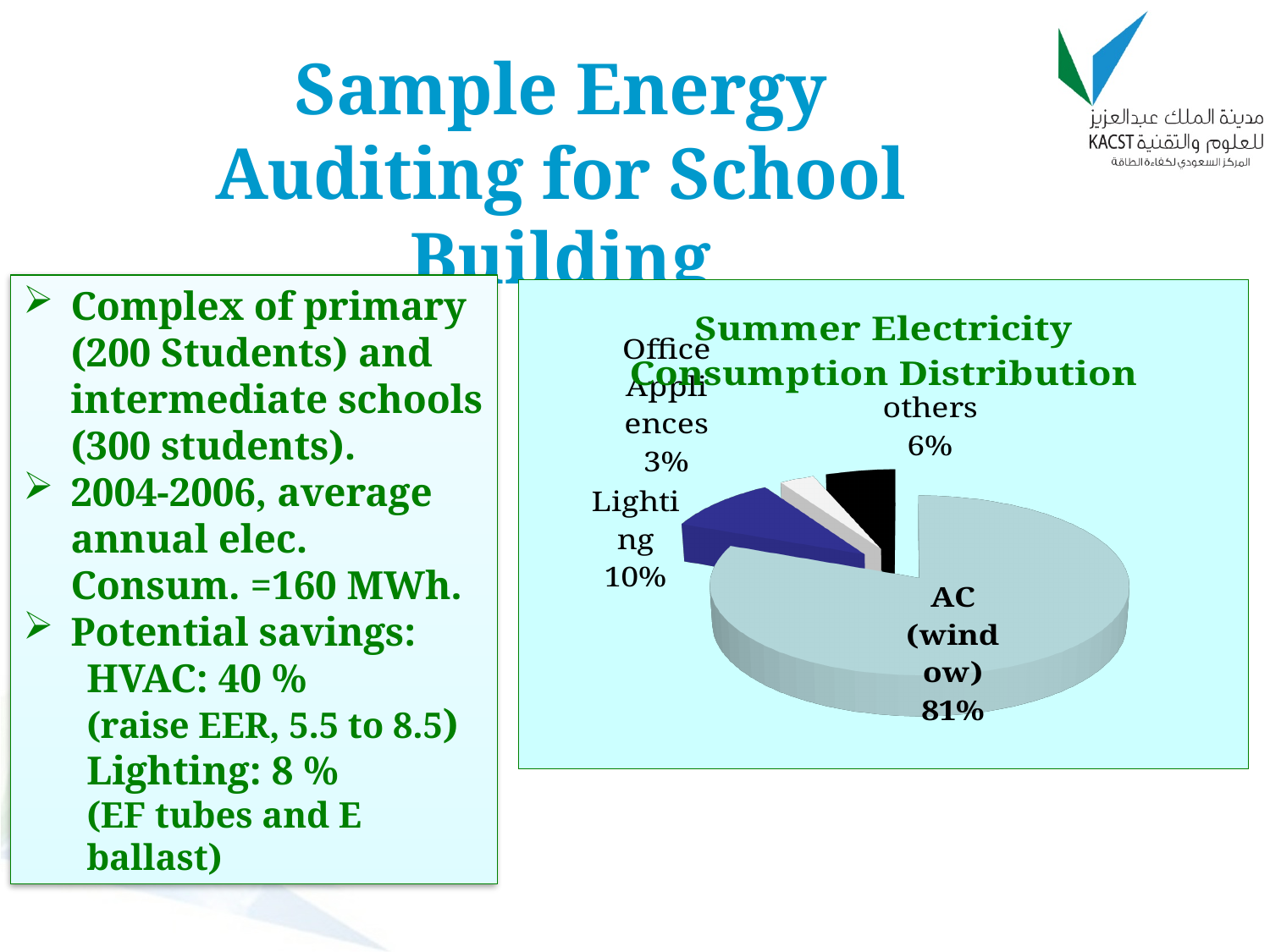
How many slices does the pie chart have? 4 What share of summer electricity consumption is attributed to Lighting? 10% What is the title of the chart? Summer Electricity Consumption Distribution What is the difference in percentage points between the AC (window) share and the Lighting share? 71 Which category has the largest share of the pie? AC (window) Which category has the smallest share of the pie? Office Appliances Which has a larger share, Lighting or others? Lighting What share of summer electricity consumption is attributed to others? 6% What share of summer electricity consumption is attributed to AC (window)? 81% What kind of chart is shown on the slide? pie chart What is the difference in percentage points between the others share and the Office Appliances share? 3